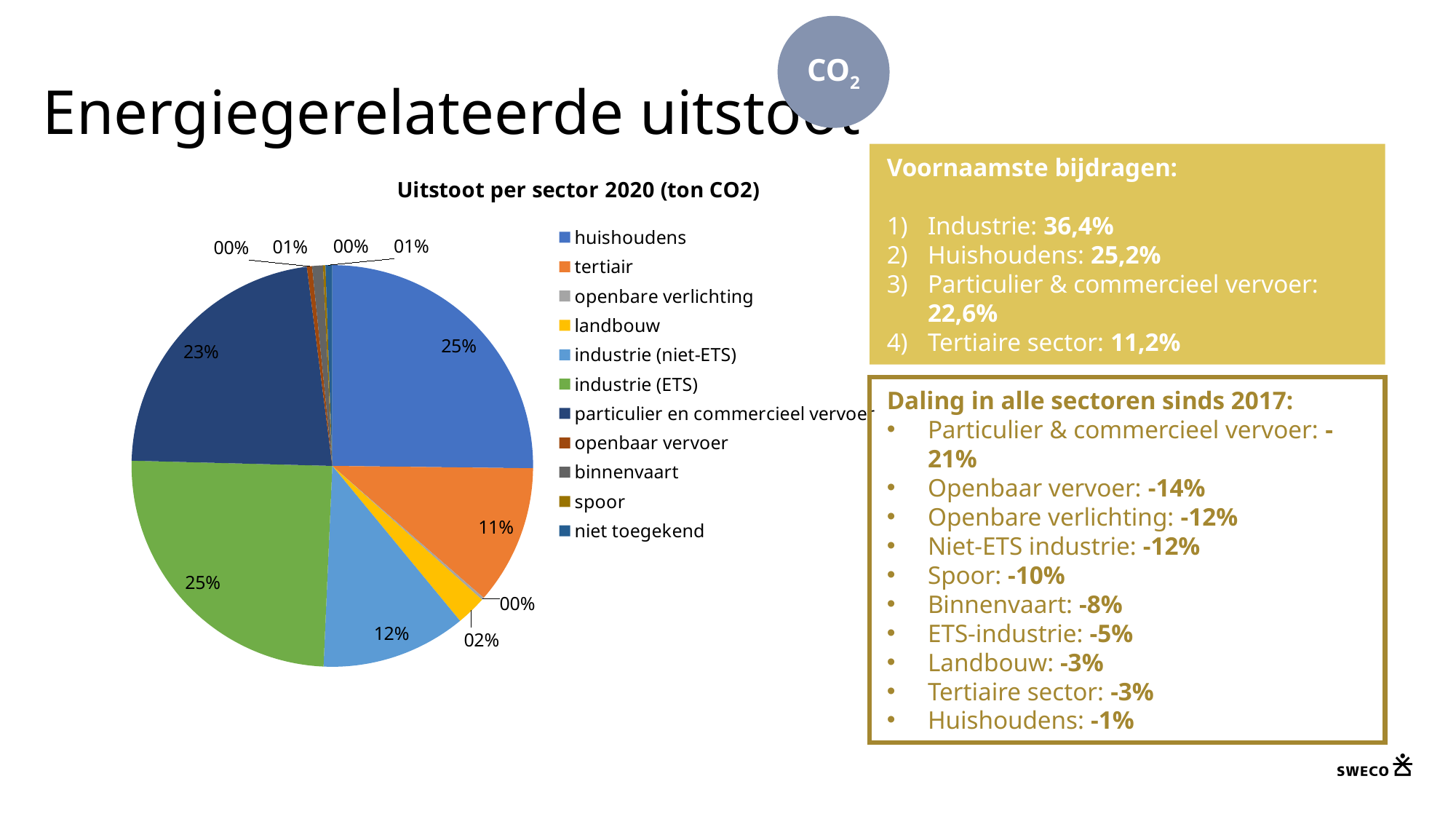
What is the value shown for landbouw? 02% What is the difference between the share for particulier en commercieel vervoer and the share for industrie (niet-ETS)? 11% What kind of chart is shown on the slide? pie chart What is the value shown for industrie (ETS)? 25% What is the value shown for particulier en commercieel vervoer? 23% What share of the pie does huishoudens have? 25% What is the title of the chart? Uitstoot per sector 2020 (ton CO2) What is the value shown for industrie (niet-ETS)? 12% Which is larger, the share for huishoudens or the share for tertiair? huishoudens How many categories does the chart's legend list? 11 What is the value shown for tertiair? 11% What is the difference between the share for huishoudens and the share for tertiair? 14%